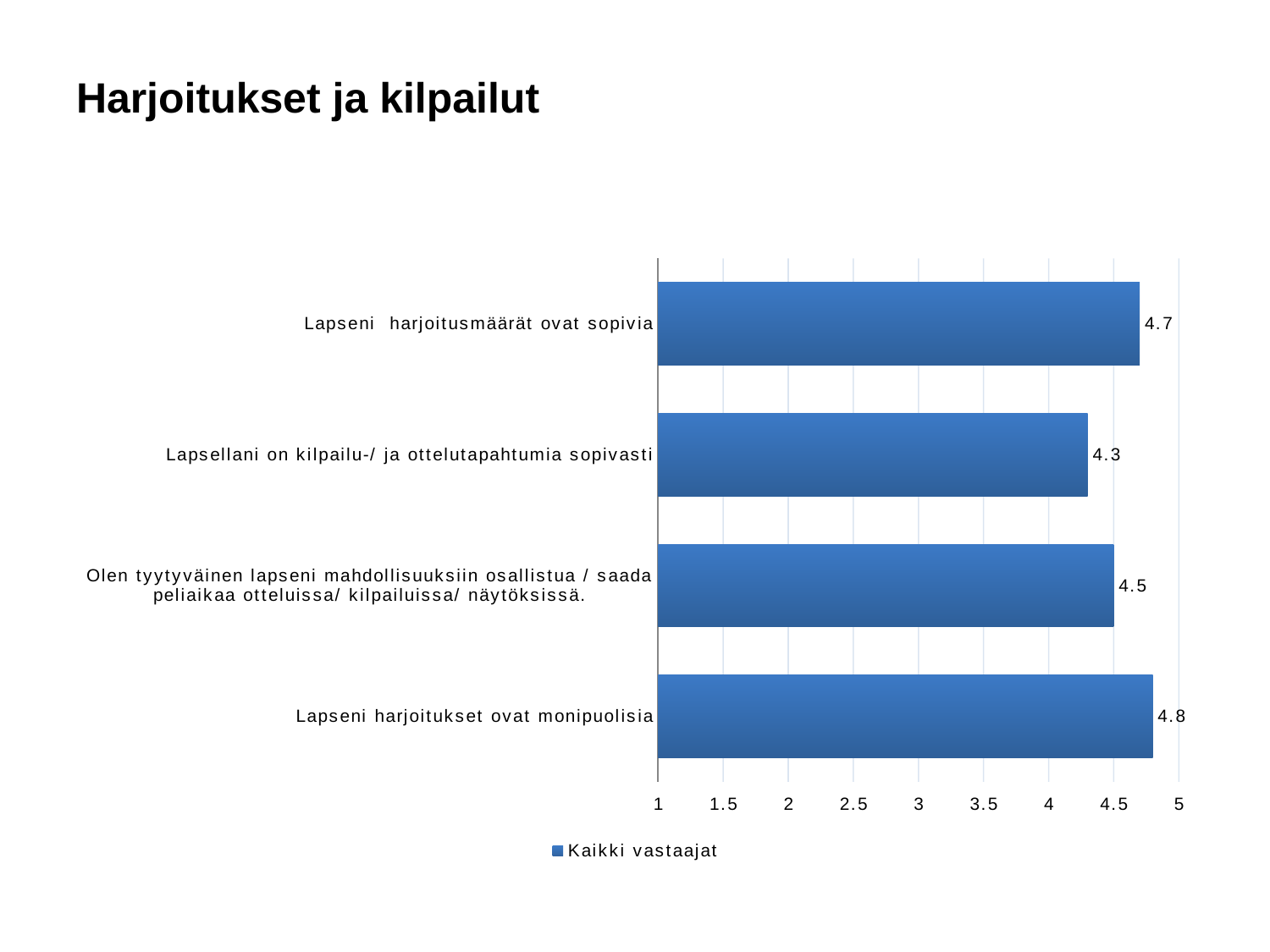
What is the value for "Olen tyytyväinen lapseni mahdollisuuksiin osallistua / saada peliaikaa otteluissa/ kilpailuissa/ näytöksissä."? 4.5 What kind of chart is shown on the slide? bar chart What is the value for "Lapsellani on kilpailu-/ ja ottelutapahtumia sopivasti"? 4.3 Which is larger: the value for "Lapseni harjoitusmäärät ovat sopivia" or the value for "Olen tyytyväinen lapseni mahdollisuuksiin osallistua / saada peliaikaa otteluissa/ kilpailuissa/ näytöksissä."? Lapseni harjoitusmäärät ovat sopivia Which category has the highest value? Lapseni harjoitukset ovat monipuolisia How many categories are shown in the chart? 4 Is the value for "Lapsellani on kilpailu-/ ja ottelutapahtumia sopivasti" greater or less than 4.5? less What is the value for "Lapseni harjoitusmäärät ovat sopivia"? 4.7 How many series does the legend list? 1 What is the difference between the values for "Lapseni harjoitukset ovat monipuolisia" and "Lapsellani on kilpailu-/ ja ottelutapahtumia sopivasti"? 0.5 Which category has the lowest value? Lapsellani on kilpailu-/ ja ottelutapahtumia sopivasti What is the value for "Lapseni harjoitukset ovat monipuolisia"? 4.8